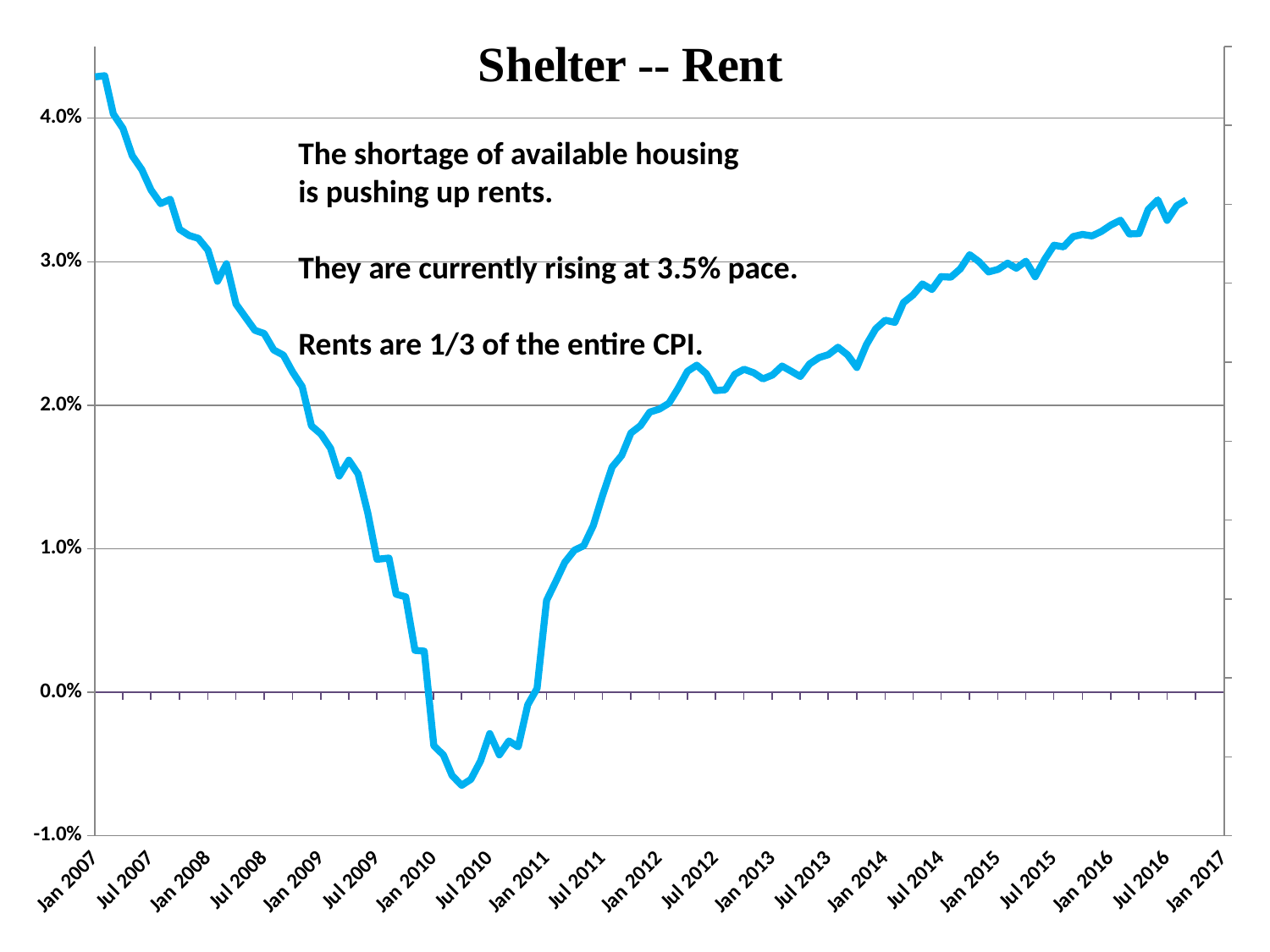
Which is larger, the value at Jan 2007 or the value at Jul 2016? Jan 2007 Is the value at Jan 2010 greater or less than 1.0%? less Is the value at Jan 2014 greater or less than 2.0%? greater Is the value at Jul 2016 greater or less than 3.0%? greater Does the line rise or fall between Jan 2007 and Jul 2010? fall Does the line rise or fall between Jan 2011 and Jul 2016? rise What kind of chart is shown on the slide? line chart What is the title of the chart? Shelter -- Rent Around which x-axis label does the line reach its lowest point? Jul 2010